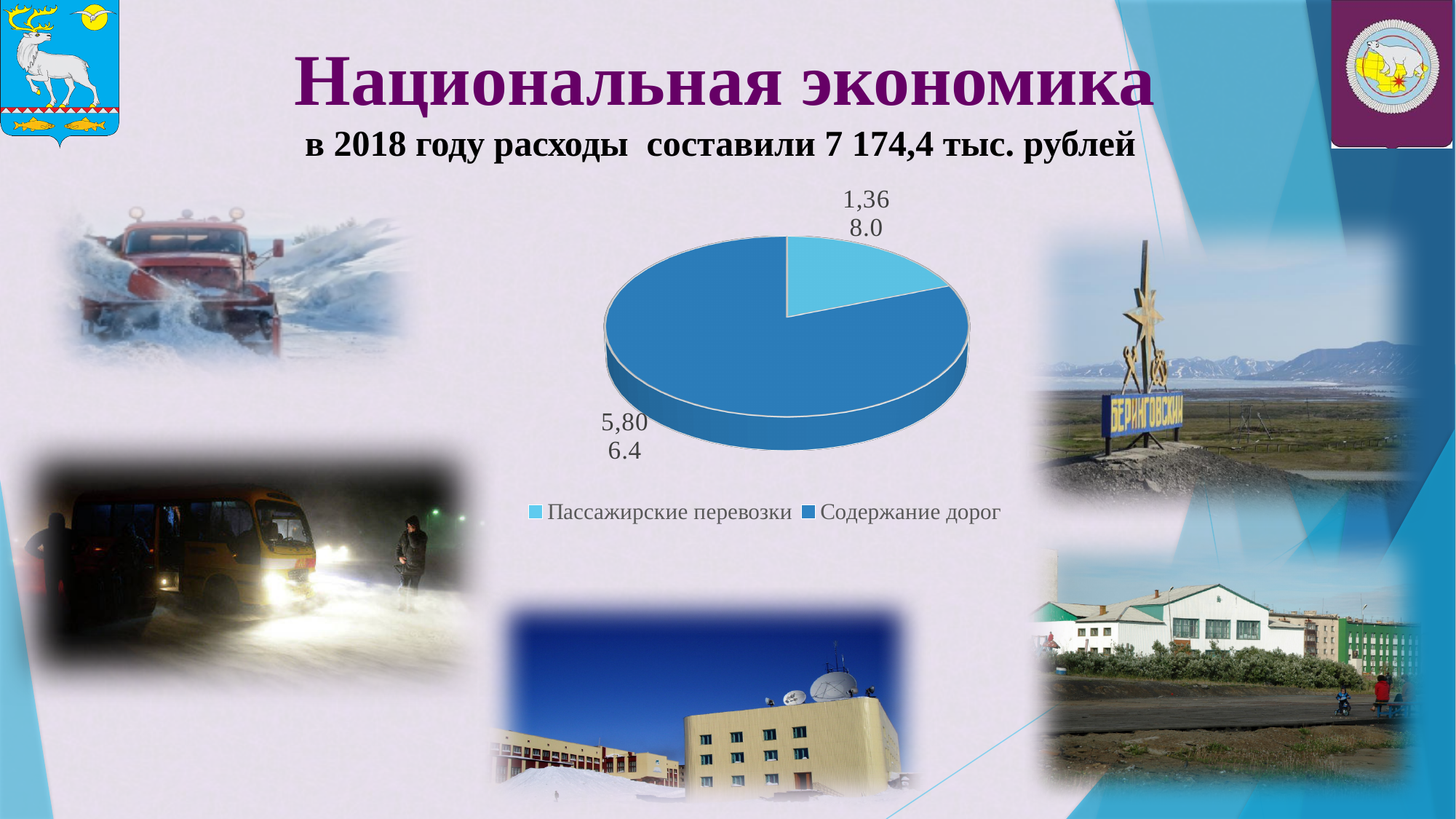
Which category has the largest slice in the pie chart? Содержание дорог What kind of chart is shown on the slide? Pie chart What is the title of the slide containing the chart? Национальная экономика What is the value for Содержание дорог in the pie chart? 5,806.4 How many categories does the pie chart show? 2 Which legend entry is shown in light blue? Пассажирские перевозки What is the value for Пассажирские перевозки in the pie chart? 1,368.0 Which is larger, Пассажирские перевозки or Содержание дорог? Содержание дорог What is the difference between the values for Содержание дорог and Пассажирские перевозки? 4,438.4 How many entries does the legend list? 2 Which category has the smallest slice in the pie chart? Пассажирские перевозки What is the total of the two values shown in the pie chart? 7,174.4